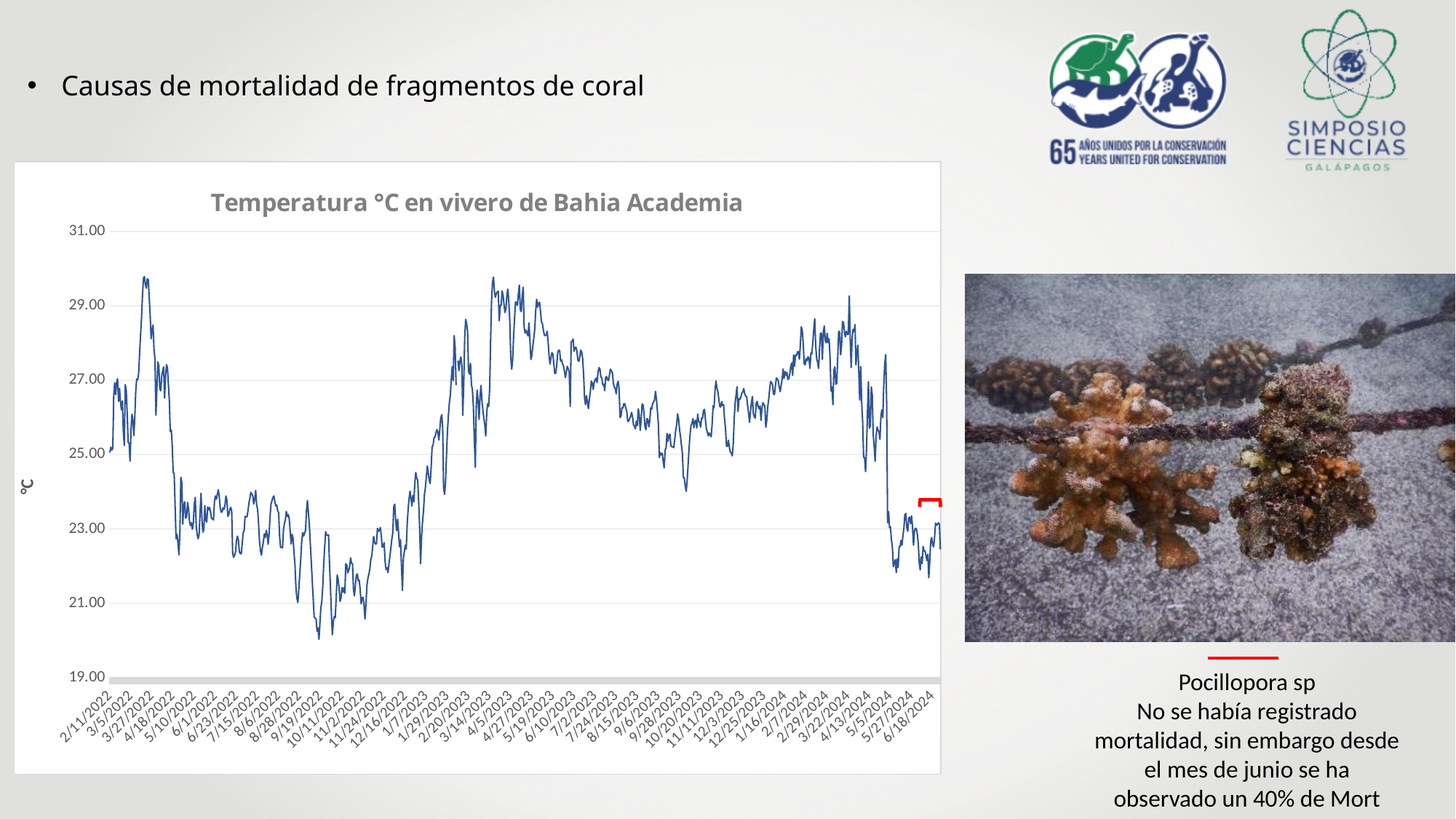
How many data series are plotted in the chart? 1 Which is higher, the temperature around 4/5/2023 or the temperature around 6/18/2024? 4/5/2023 What is the title of the chart? Temperatura °C en vivero de Bahia Academia Is the temperature around 9/19/2022 greater or less than 21.00? less What is the highest value shown on the vertical axis of the chart? 31.00 Does the temperature rise or fall between 9/19/2022 and 4/5/2023? rise What is the first date label on the horizontal axis? 2/11/2022 What is the label on the vertical axis of the chart? °C Is the peak temperature around 3/27/2022 greater or less than 29.00? greater What is the lowest value shown on the vertical axis of the chart? 19.00 What is the last date label on the horizontal axis? 6/18/2024 What kind of chart is shown on the slide? line chart